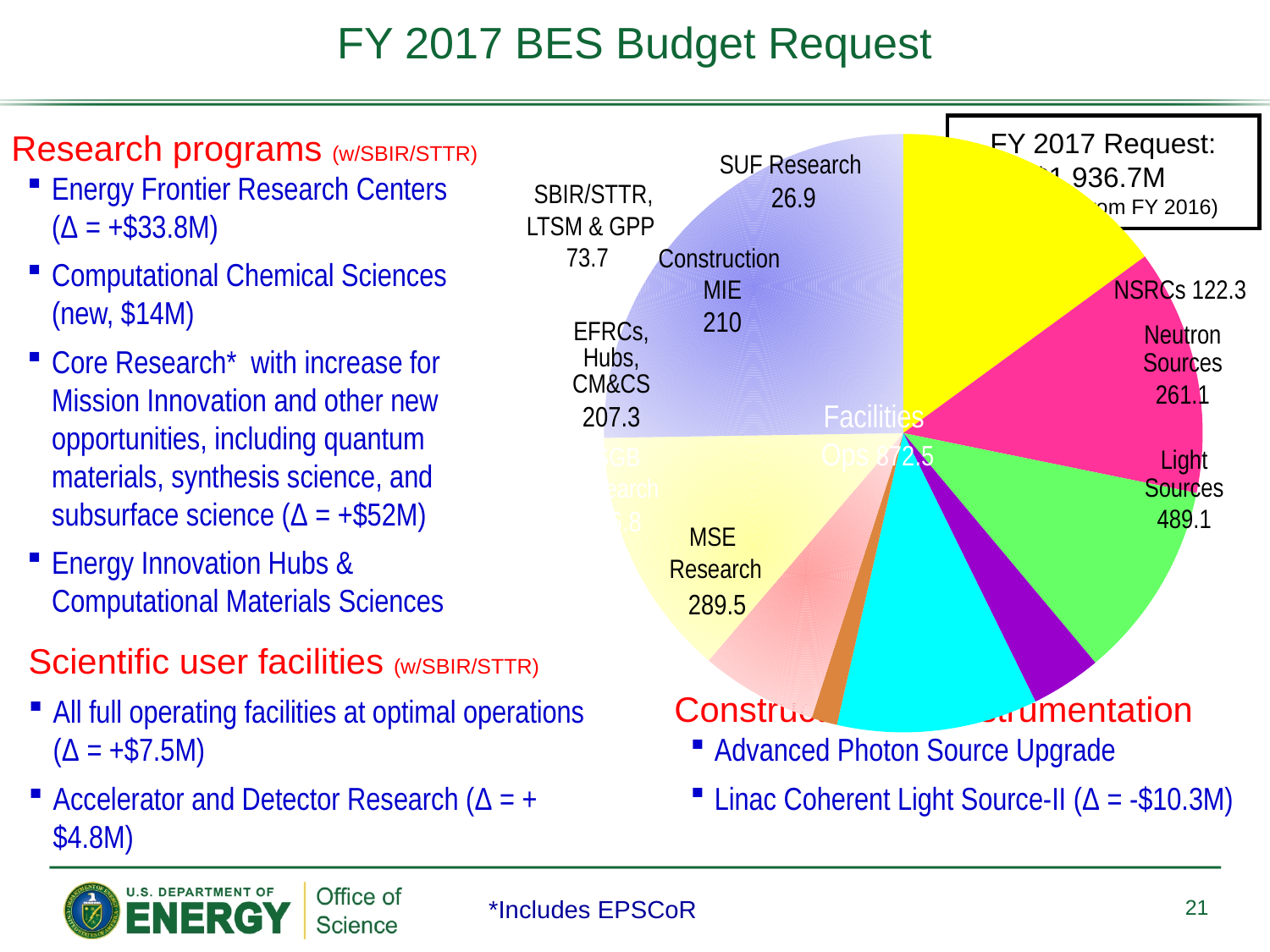
What is the value shown for SUF Research in the pie chart? 26.9 Which is larger in the pie chart, Light Sources or Neutron Sources? Light Sources What is the value shown for NSRCs in the pie chart? 122.3 What is the value shown for SBIR/STTR, LTSM & GPP in the pie chart? 73.7 What kind of chart is shown on the slide? pie chart What is the value shown for Construction MIE in the pie chart? 210 Which is larger in the pie chart, MSE Research or Construction MIE? MSE Research What is the difference between the Light Sources value and the Neutron Sources value in the pie chart? 228.0 What is the value shown for EFRCs, Hubs, CM&CS in the pie chart? 207.3 What is the value shown for MSE Research in the pie chart? 289.5 What is the value shown for Light Sources in the pie chart? 489.1 What is the value shown for Neutron Sources in the pie chart? 261.1